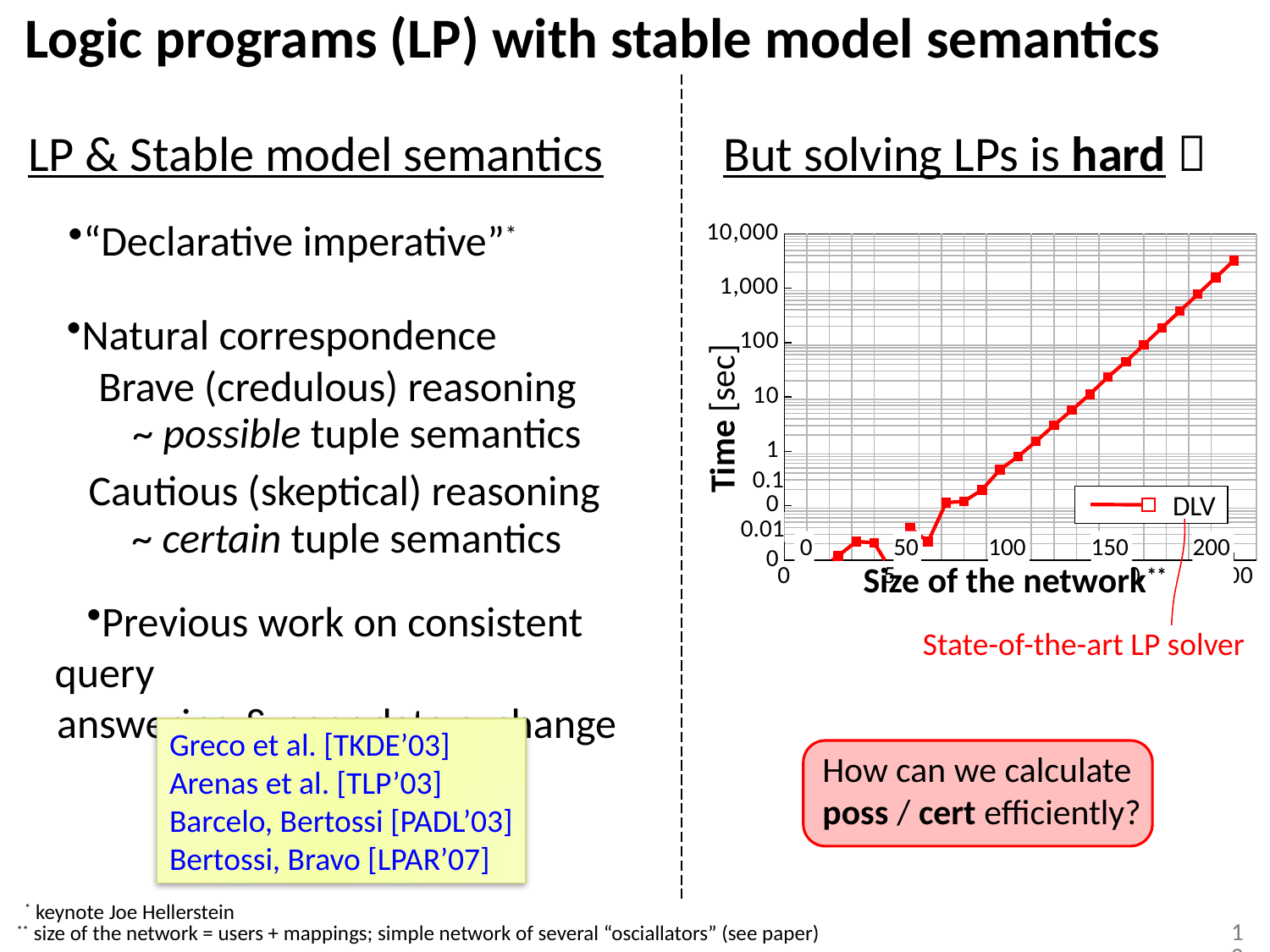
Does the time rise or fall as the size of the network increases? rise How many series does the chart's legend list? 1 Is the time for the largest network size plotted greater or less than 10,000 seconds? less What is the name of the series shown in the chart's legend? DLV Is the time at a network size of 150 greater or less than 1 second? greater Is the time at a network size of 100 greater or less than 10 seconds? less What kind of chart is shown on the slide? line chart What is the label of the chart's vertical axis? Time [sec]